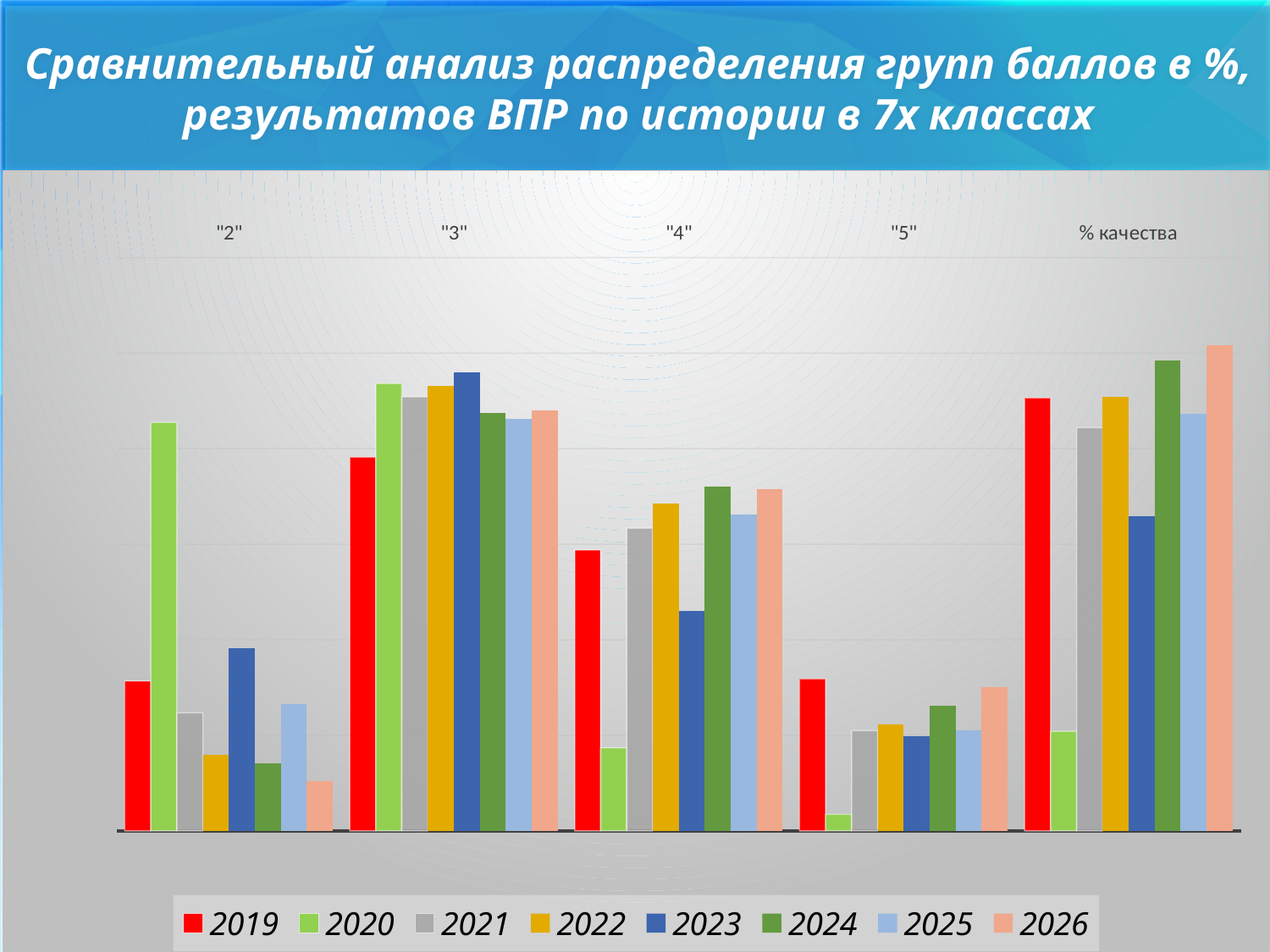
In the "2" category, which year has the lowest bar? 2026 What kind of chart is shown on the slide? bar chart In the "4" category, which is larger: the bar for 2022 or the bar for 2023? 2022 In the "5" category, which year has the lowest bar? 2020 In the "% качества" category, which year has the highest bar? 2026 In the "2" category, which year has the highest bar? 2020 In the "2" category, which is larger: the bar for 2019 or the bar for 2021? 2019 How many series does the legend list? 8 How many categories are shown along the x axis of the chart? 5 In the "3" category, which year has the lowest bar? 2019 Which year is shown in red in the legend? 2019